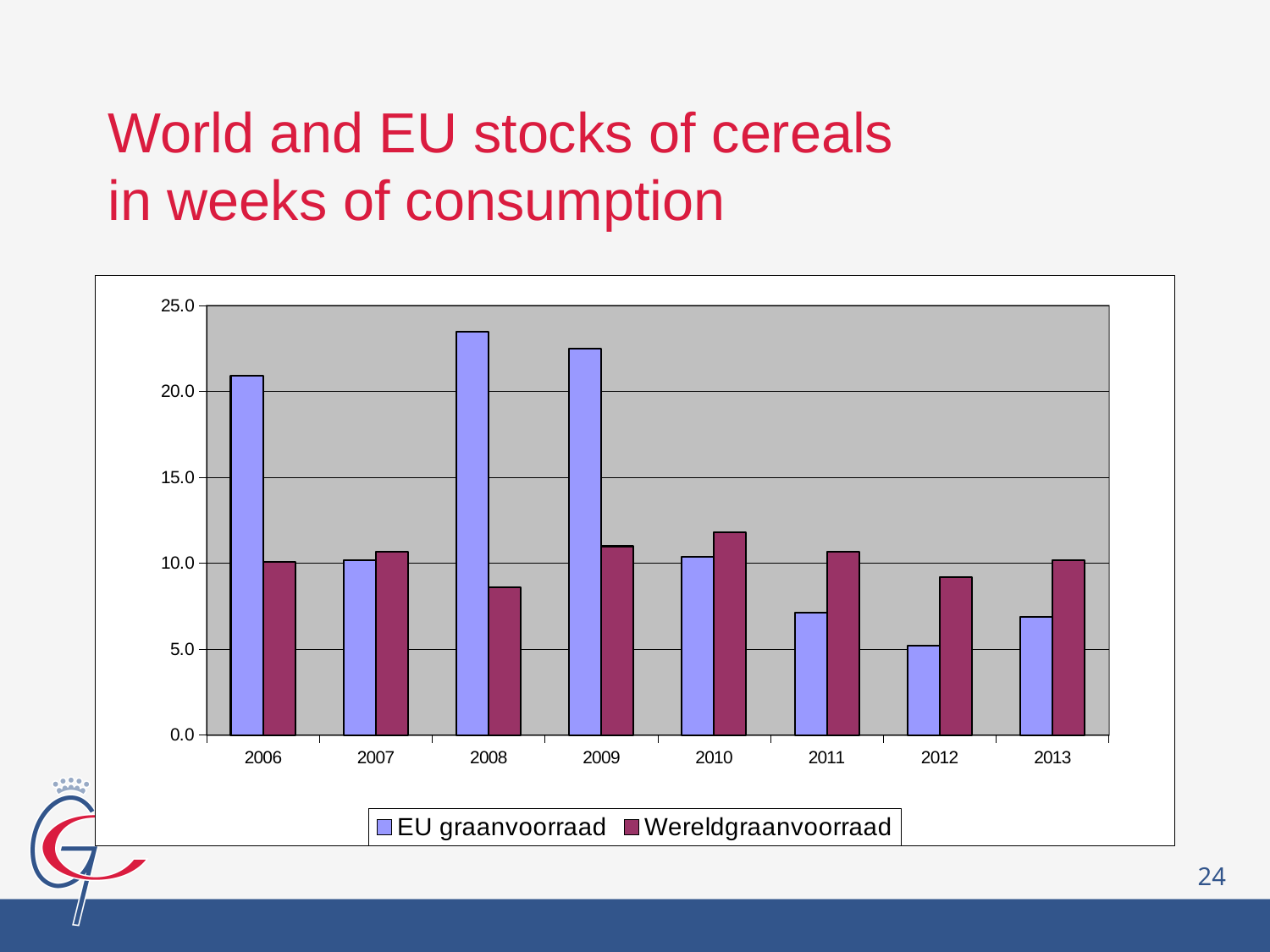
Is the Wereldgraanvoorraad value for 2008 greater or less than 10.0? less In which year is the EU graanvoorraad highest? 2008 In 2012, which is larger: EU graanvoorraad or Wereldgraanvoorraad? Wereldgraanvoorraad Is the EU graanvoorraad value for 2006 greater or less than 20.0? greater What kind of chart is shown on the slide? bar chart How many years are shown on the x axis? 8 In which year is the EU graanvoorraad lowest? 2012 Is the EU graanvoorraad value for 2011 greater or less than 10.0? less Does the EU graanvoorraad rise or fall from 2009 to 2012? fall In 2009, which is larger: EU graanvoorraad or Wereldgraanvoorraad? EU graanvoorraad How many series does the legend list? 2 In which year is the Wereldgraanvoorraad lowest? 2008